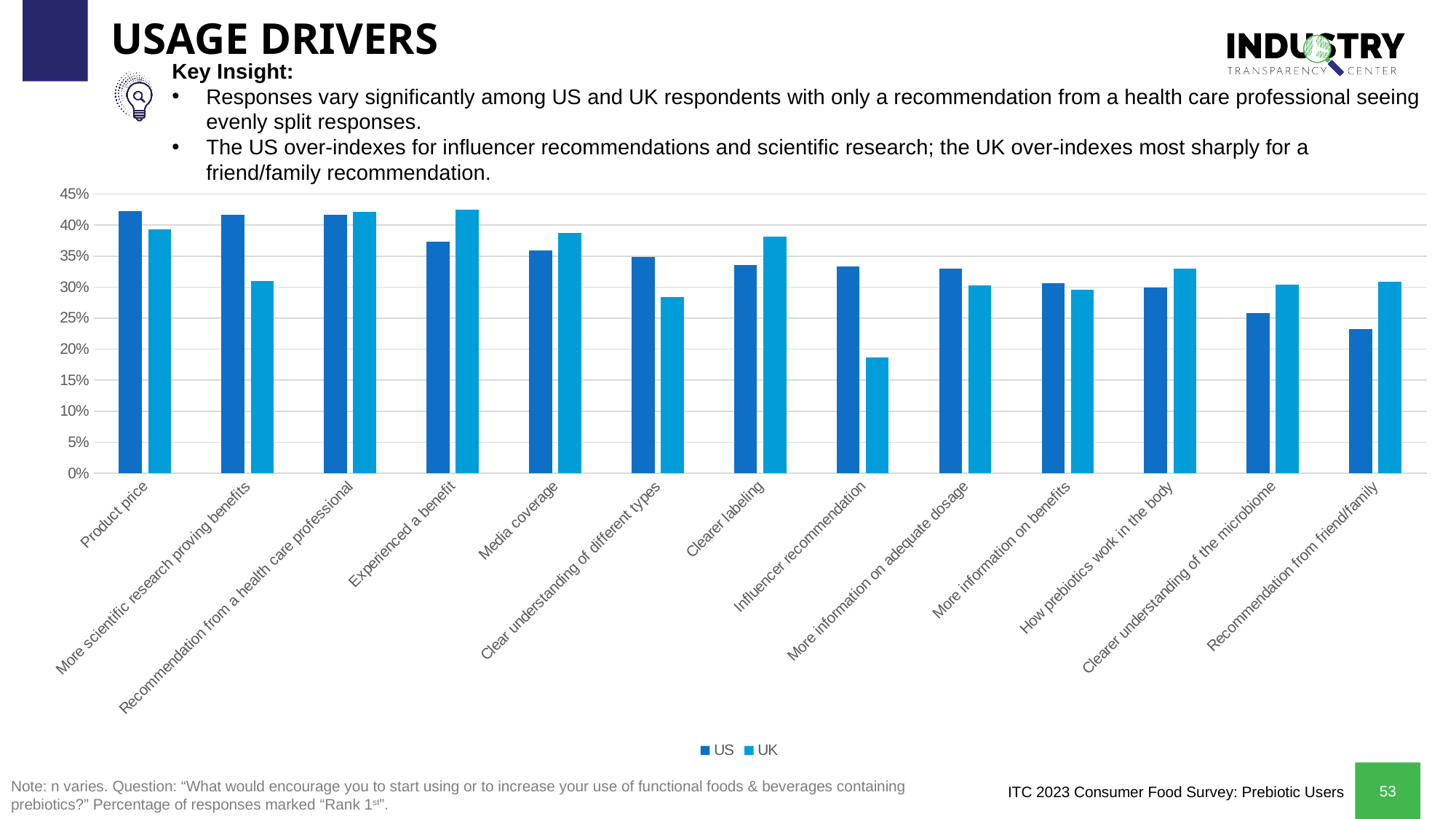
Which category has the lowest UK value? Influencer recommendation Which series has the lowest value for Influencer recommendation, US or UK? UK Is the UK value for Influencer recommendation greater or less than 20%? less Do the US values generally rise or fall moving from left to right along the x axis? fall How many series does the legend list? 2 Which category has the lowest US value? Recommendation from friend/family How many categories are shown on the x axis of the chart? 13 Is the US value for Product price greater or less than 40%? greater Which series has the higher value for Recommendation from friend/family, US or UK? UK Is the US value for Recommendation from friend/family greater or less than 25%? less What kind of chart is shown on the slide? bar chart Which series has the higher value for More scientific research proving benefits, US or UK? US